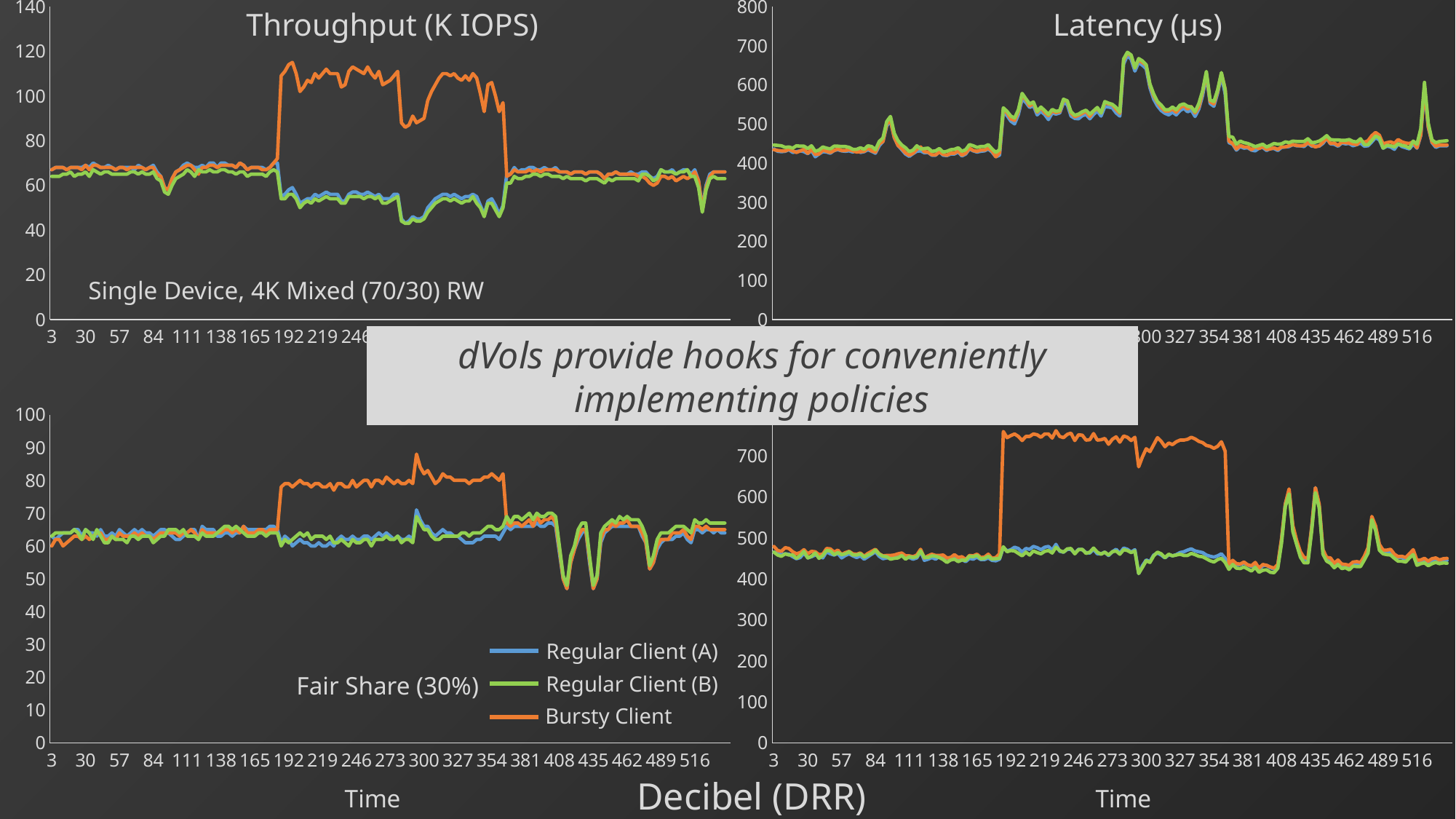
In the Fair Share (30%) chart at the bottom left, is the value for Bursty Client at time 246 greater or less than 70? greater What kind of chart is the Throughput (K IOPS) chart at the top left? line chart What are the three series named in the legend? Regular Client (A), Regular Client (B), Bursty Client In the Throughput (K IOPS) chart at the top left, is the value for Regular Client (B) at time 246 greater or less than 60? less In the bottom-right chart (Decibel (DRR) latency), is the value for Regular Client (A) at time 111 greater or less than 500? less In the Throughput (K IOPS) chart at the top left, which is larger at time 219: Bursty Client or Regular Client (A)? Bursty Client How many series does the legend on the slide list? 3 What is the title of the top-right chart? Latency (µs)